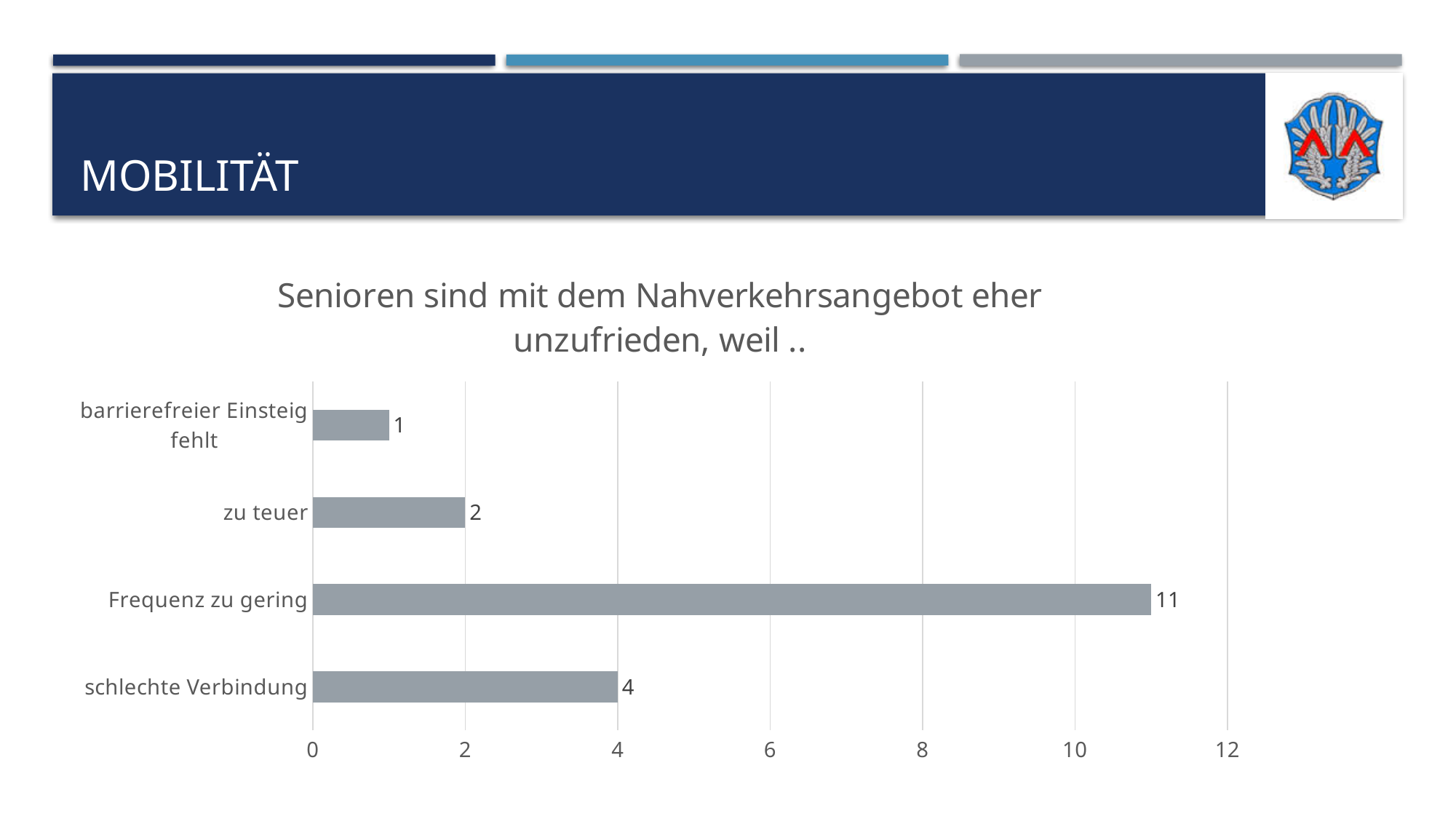
What is the difference between the values for "Frequenz zu gering" and "schlechte Verbindung"? 7 Which category has the highest value? Frequenz zu gering Is the value for "Frequenz zu gering" greater or less than 10? greater What is the value for "barrierefreier Einsteig fehlt"? 1 What is the value for "Frequenz zu gering"? 11 What is the value for "schlechte Verbindung"? 4 Which is larger, the value for "zu teuer" or the value for "schlechte Verbindung"? schlechte Verbindung What kind of chart is shown on the slide? bar chart Which category has the lowest value? barrierefreier Einsteig fehlt What is the title of the chart? Senioren sind mit dem Nahverkehrsangebot eher unzufrieden, weil .. What is the value for "zu teuer"? 2 How many categories are shown in the chart? 4